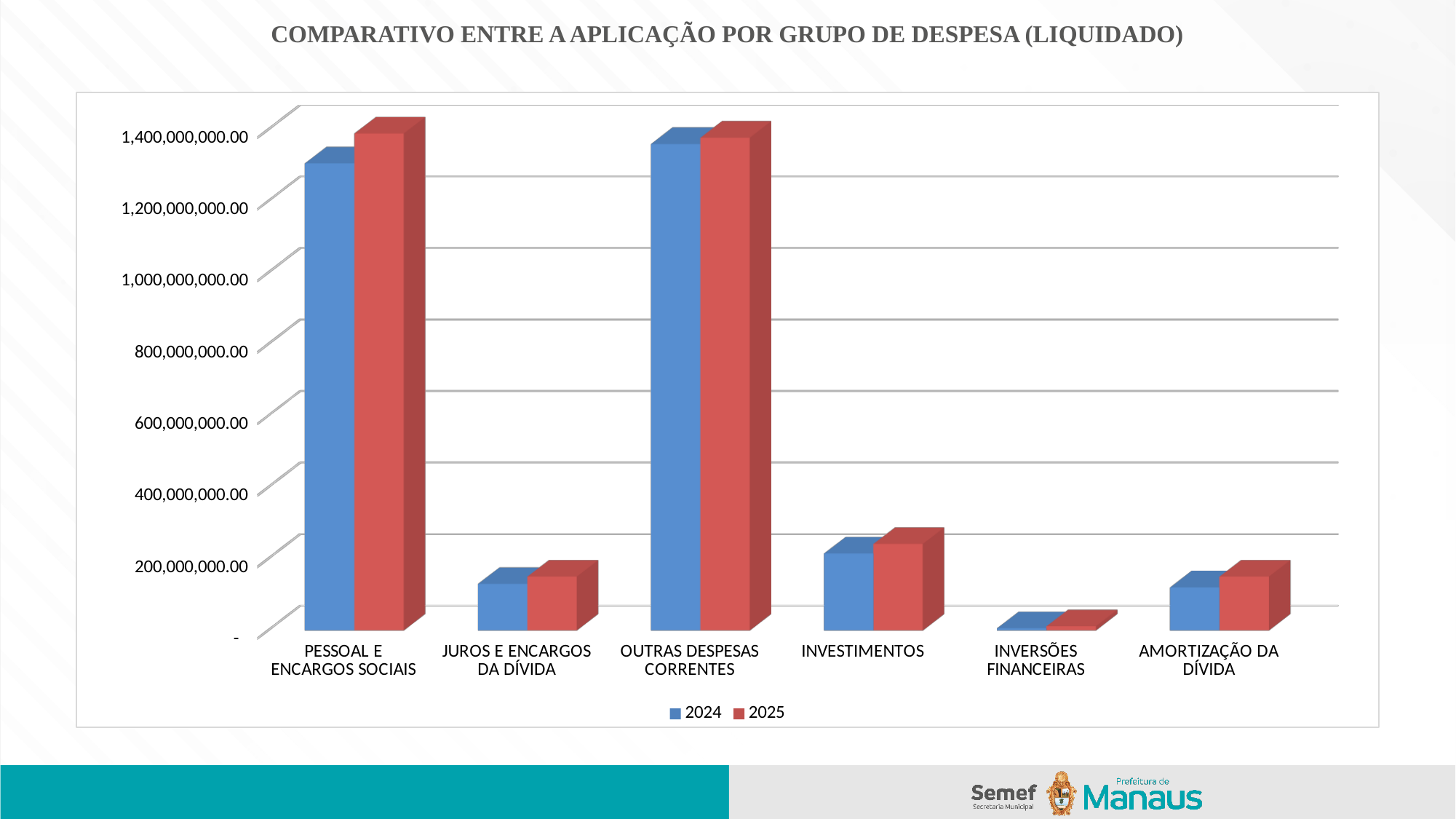
Which years are listed in the legend? 2024 and 2025 Which category has the lowest values for both 2024 and 2025? INVERSÕES FINANCEIRAS Is the 2024 value for INVERSÕES FINANCEIRAS greater or less than 200,000,000.00? less For PESSOAL E ENCARGOS SOCIAIS, which year has the larger value, 2024 or 2025? 2025 How many expense groups (categories) are shown on the x axis? 6 Is the 2024 value for PESSOAL E ENCARGOS SOCIAIS greater or less than 1,200,000,000.00? greater What kind of chart is shown on the slide? Bar chart For 2025, which is larger: INVESTIMENTOS or JUROS E ENCARGOS DA DÍVIDA? INVESTIMENTOS What is the title of the chart? COMPARATIVO ENTRE A APLICAÇÃO POR GRUPO DE DESPESA (LIQUIDADO) Is the 2025 value for INVESTIMENTOS greater or less than 400,000,000.00? less How many series does the legend list? 2